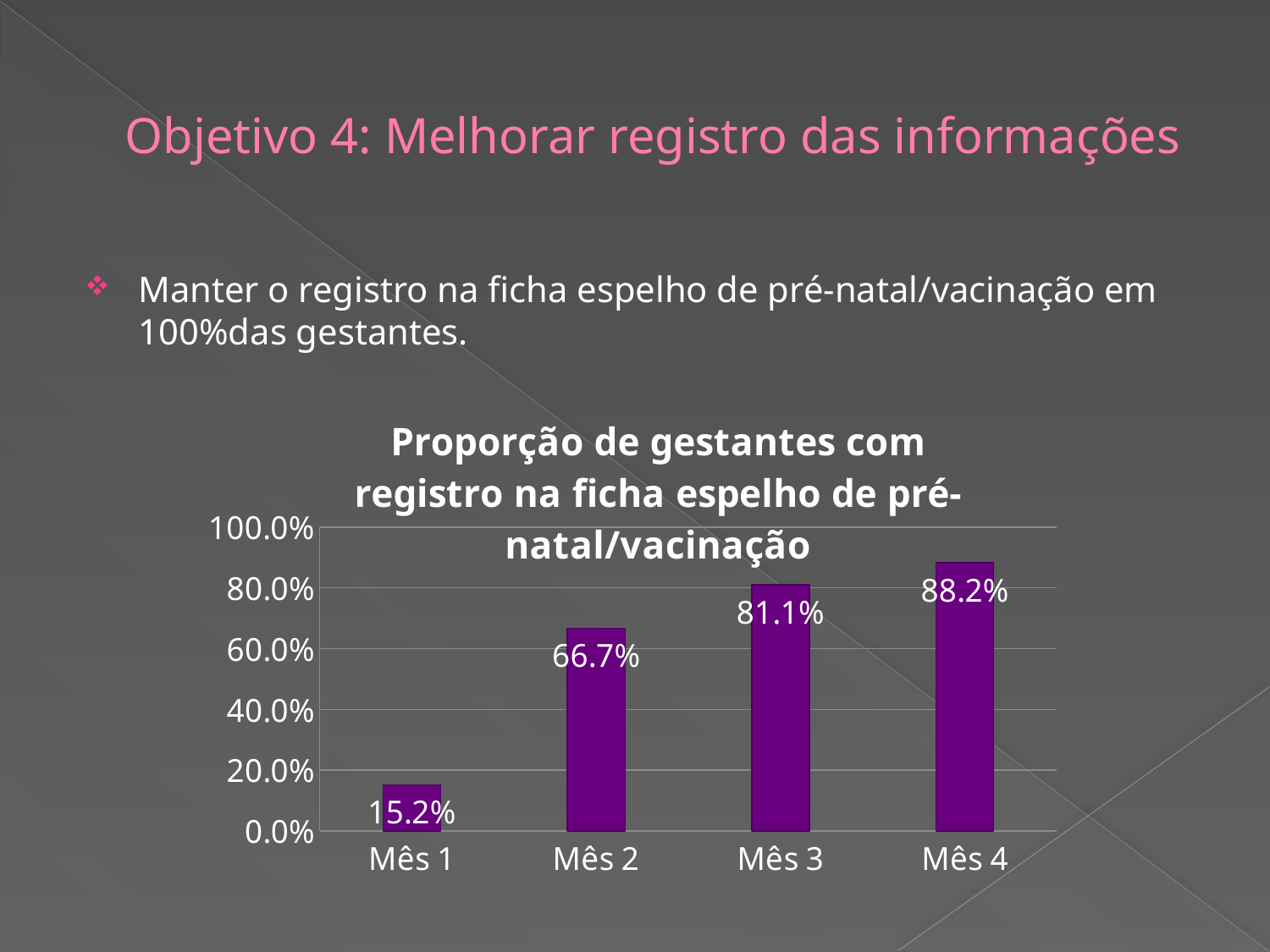
What is the value for Mês 1? 15.2% What kind of chart is shown on the slide? bar chart What is the difference between the values for Mês 2 and Mês 1? 51.5% What is the value for Mês 4? 88.2% Which is larger, the value for Mês 2 or the value for Mês 3? Mês 3 What is the value for Mês 2? 66.7% Do the values rise or fall from Mês 1 to Mês 4? rise What is the value for Mês 3? 81.1% How many months are shown on the x axis? 4 Which month has the highest value? Mês 4 What is the difference between the values for Mês 4 and Mês 3? 7.1% Which month has the lowest value? Mês 1